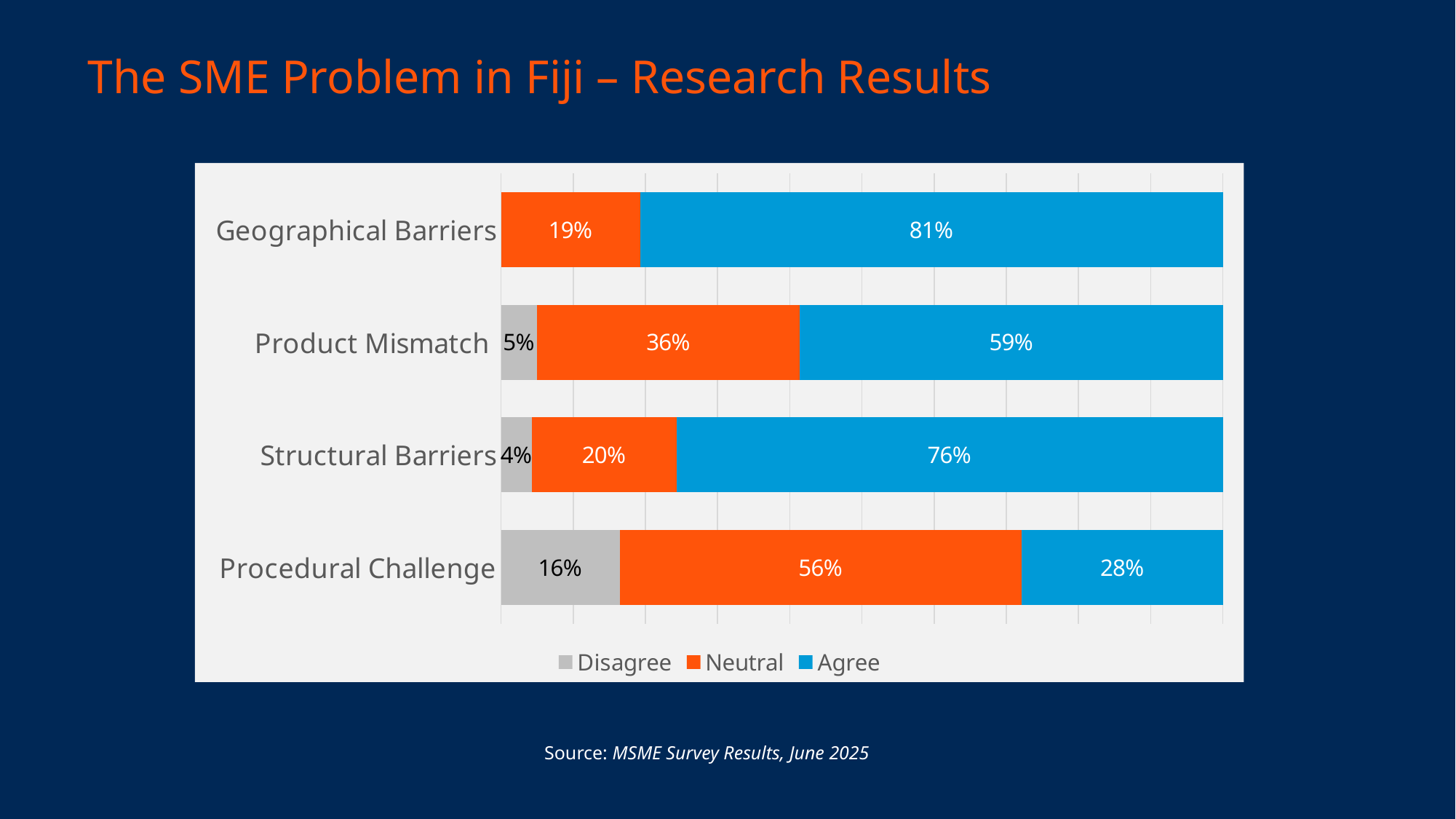
Which category has the highest Agree value? Geographical Barriers What is the Neutral value for Product Mismatch? 36% What is the total of the Disagree, Neutral and Agree values for Structural Barriers? 100% What kind of chart is shown on the slide? Stacked bar chart What is the Agree value for Structural Barriers? 76% How many categories are shown in the chart? 4 Which category has the lowest Agree value? Procedural Challenge What percentage of respondents agree that Geographical Barriers are a problem? 81% What is the Disagree value for Procedural Challenge? 16% Which is larger: the Neutral value for Procedural Challenge or the Neutral value for Product Mismatch? Procedural Challenge What is the difference between the Agree values for Geographical Barriers and Procedural Challenge? 53% How many series does the legend list? 3